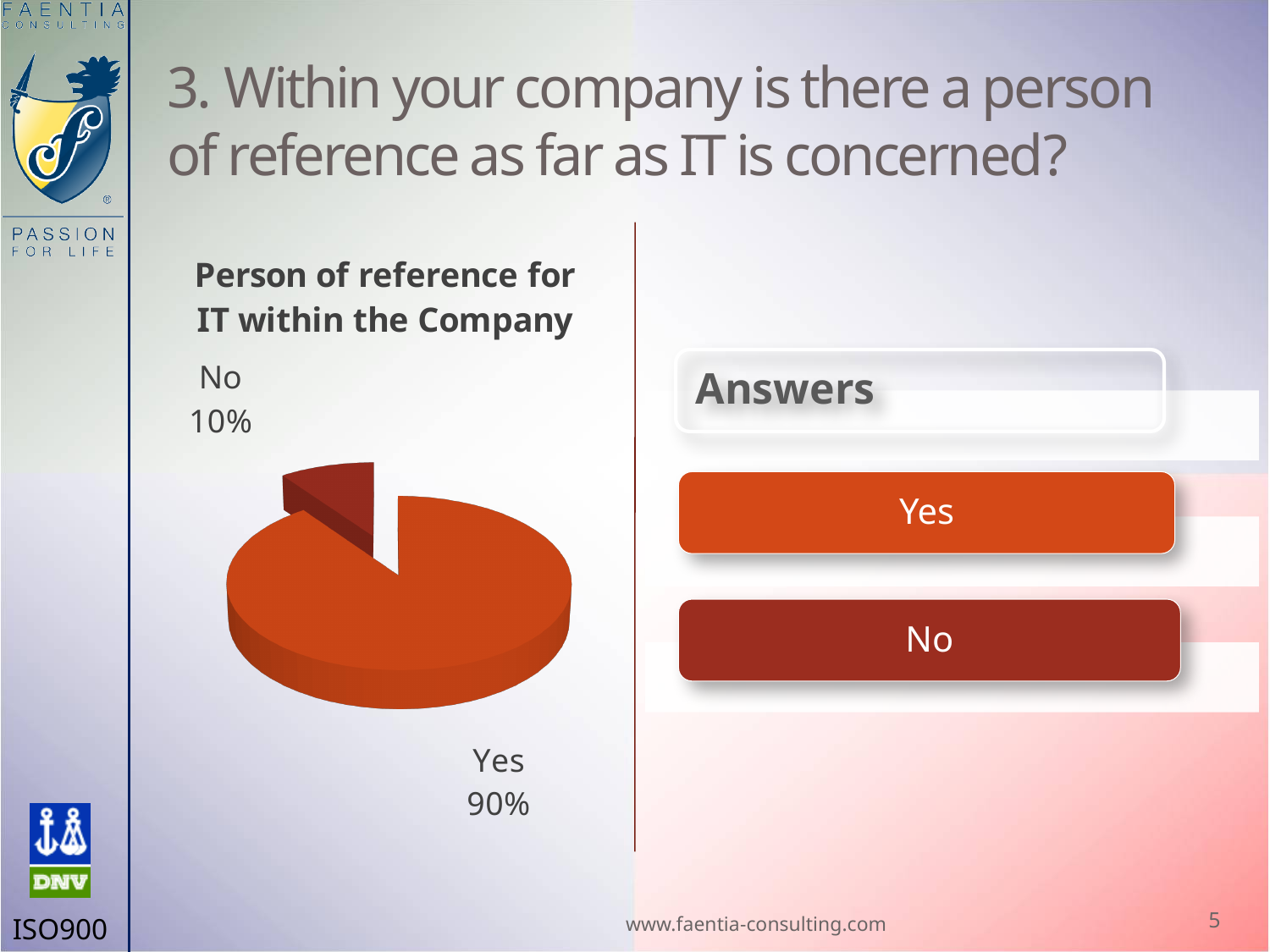
How many slices does the pie chart have? 2 What share of the pie does the "Yes" slice represent? 90% What is the title of the chart? Person of reference for IT within the Company What is the value shown for the "Yes" category? 90% Which slice of the pie is the smallest? No What is the value shown for the "No" category? 10% What colour is the "No" slice of the pie? dark red What share of the pie does the "No" slice represent? 10% Which slice of the pie is the largest? Yes What is the difference in percentage points between the "Yes" and "No" slices? 80 What kind of chart is shown on the slide? pie chart Which is larger, the "Yes" slice or the "No" slice? Yes